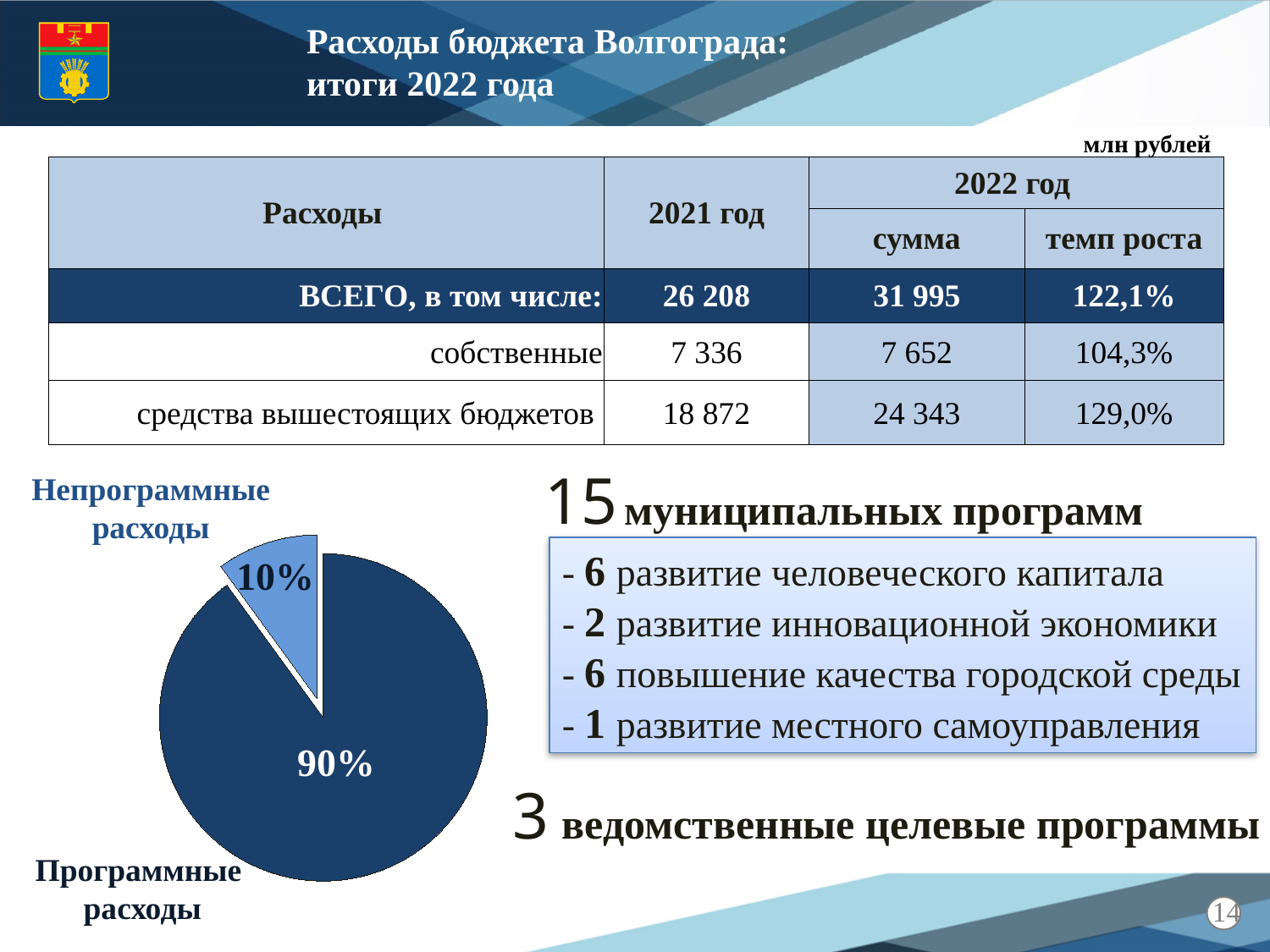
What share of the pie chart is labelled "Программные расходы"? 90% Is the "Непрограммные расходы" slice of the pie chart pulled out (exploded) from the rest of the pie? yes What is the difference in percentage points between the "Программные расходы" slice and the "Непрограммные расходы" slice? 80 How many slices does the pie chart have? 2 What share of the pie chart is labelled "Непрограммные расходы"? 10% What is the total of the two slices shown in the pie chart? 100% Which slice of the pie chart is the smallest? Непрограммные расходы Which slice of the pie chart is shown in the lighter blue colour? Непрограммные расходы Which slice of the pie chart is the largest? Программные расходы Which is larger in the pie chart: "Программные расходы" or "Непрограммные расходы"? Программные расходы What kind of chart is shown on the slide? pie chart